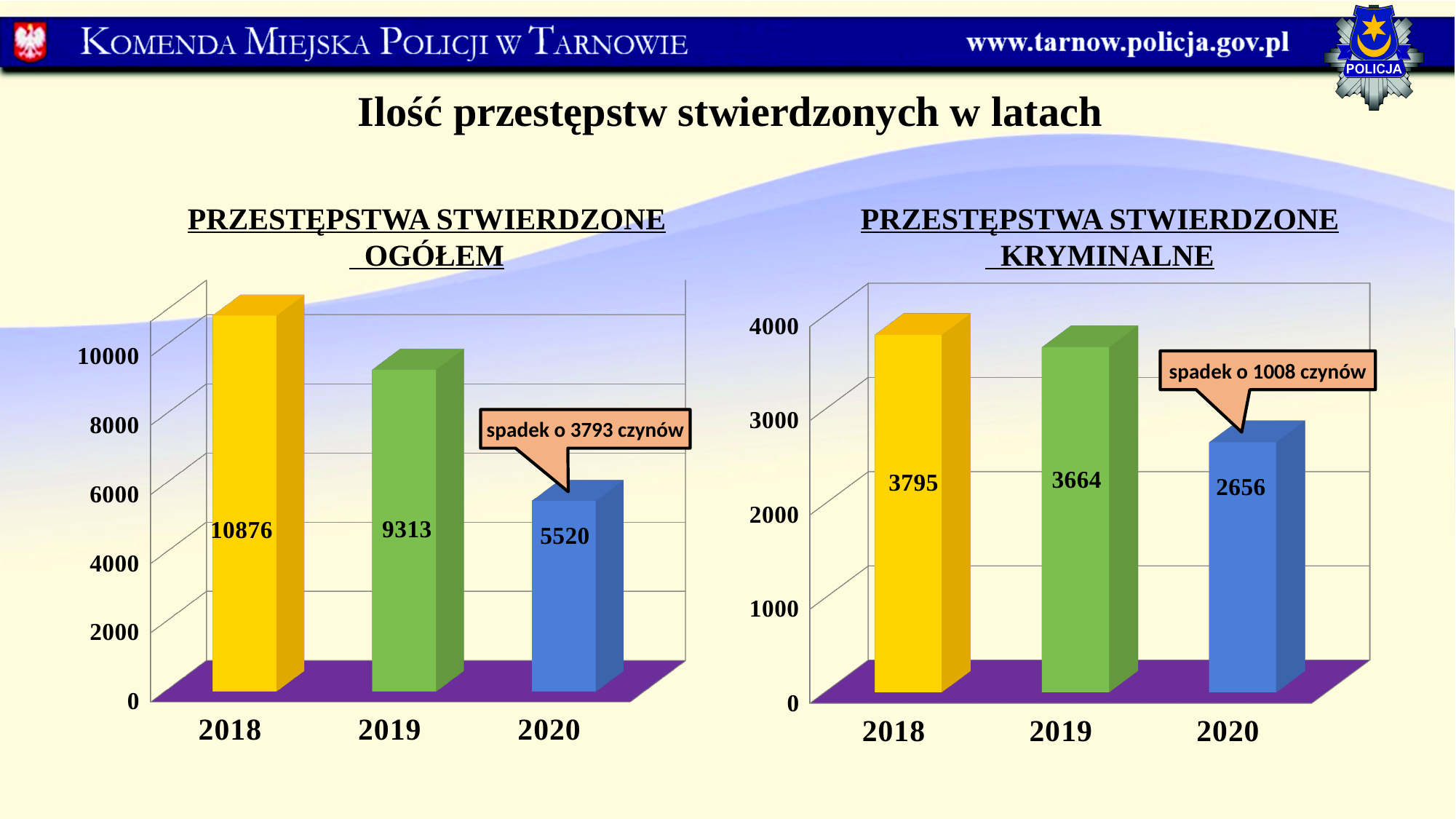
In the chart titled PRZESTĘPSTWA STWIERDZONE OGÓŁEM, what is the value for 2018? 10876 In the chart titled PRZESTĘPSTWA STWIERDZONE KRYMINALNE, what is the value for 2019? 3664 In the chart titled PRZESTĘPSTWA STWIERDZONE OGÓŁEM, which year has the highest value? 2018 In the chart titled PRZESTĘPSTWA STWIERDZONE KRYMINALNE, what is the difference between the 2018 and 2019 values? 131 In the chart titled PRZESTĘPSTWA STWIERDZONE OGÓŁEM, what is the difference between the 2019 and 2020 values? 3793 How many years are shown on the x axis of the chart titled PRZESTĘPSTWA STWIERDZONE OGÓŁEM? 3 In the chart titled PRZESTĘPSTWA STWIERDZONE KRYMINALNE, which is larger, the value for 2018 or the value for 2020? 2018 What kind of chart is the chart titled PRZESTĘPSTWA STWIERDZONE KRYMINALNE? Bar chart In the chart titled PRZESTĘPSTWA STWIERDZONE KRYMINALNE, which year has the lowest value? 2020 In the chart titled PRZESTĘPSTWA STWIERDZONE OGÓŁEM, what is the value for 2020? 5520 In the chart titled PRZESTĘPSTWA STWIERDZONE KRYMINALNE, what is the value for 2020? 2656 In the chart titled PRZESTĘPSTWA STWIERDZONE OGÓŁEM, do the values rise or fall from 2018 to 2020? Fall